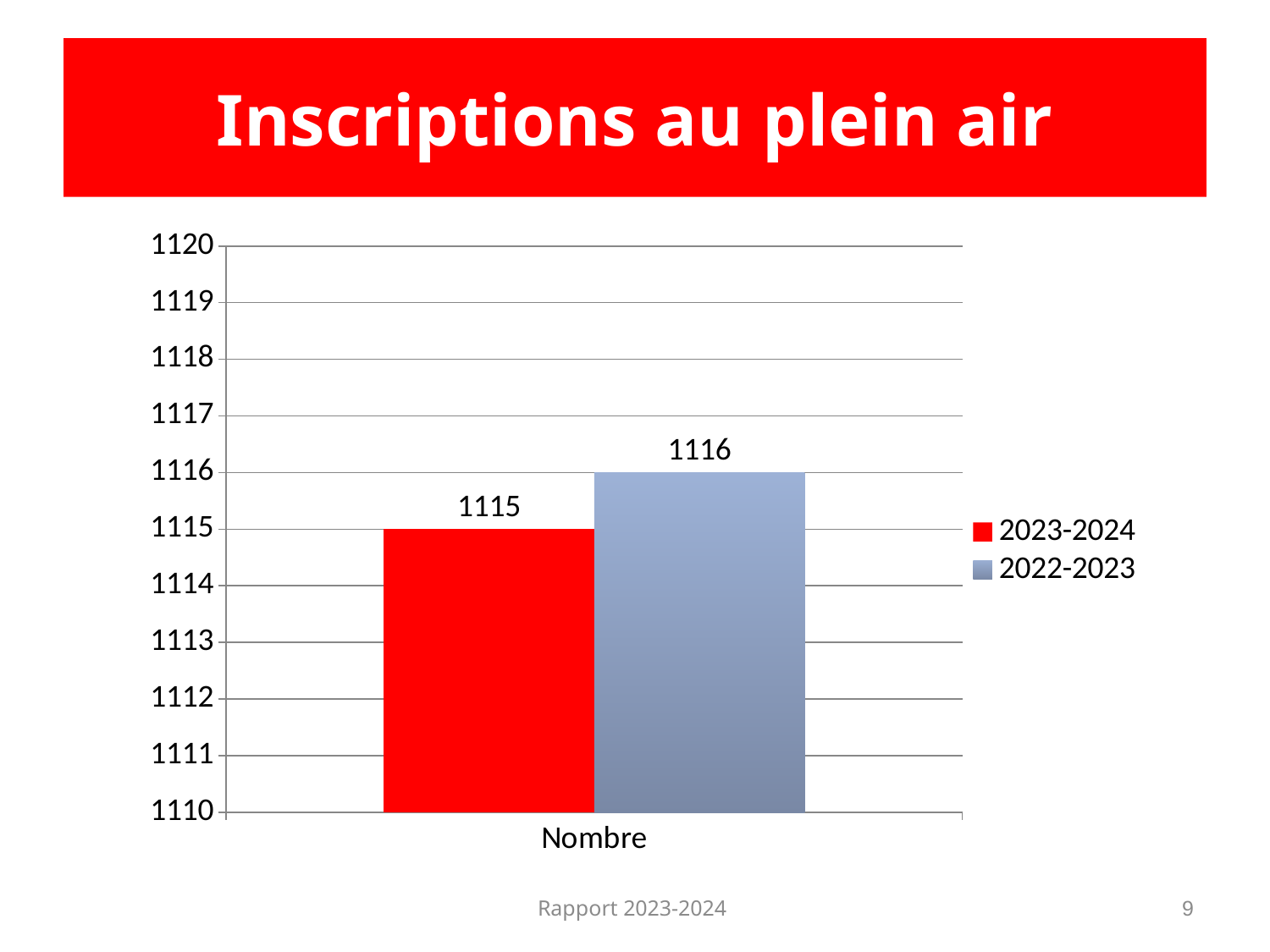
What is the value for 2023-2024 in the Nombre category? 1115 What colour is the bar for the 2023-2024 series? red Which series has the highest value on the chart? 2022-2023 How many series does the legend list? 2 Which series has the higher value for Nombre, 2023-2024 or 2022-2023? 2022-2023 What is the value for 2022-2023 in the Nombre category? 1116 How many categories are shown on the x axis? 1 What is the difference between the 2022-2023 value and the 2023-2024 value? 1 Is the value for 2023-2024 greater or less than 1118? less Which series has the lowest value on the chart? 2023-2024 What is the title of the slide containing the chart? Inscriptions au plein air What kind of chart is shown on the slide? bar chart